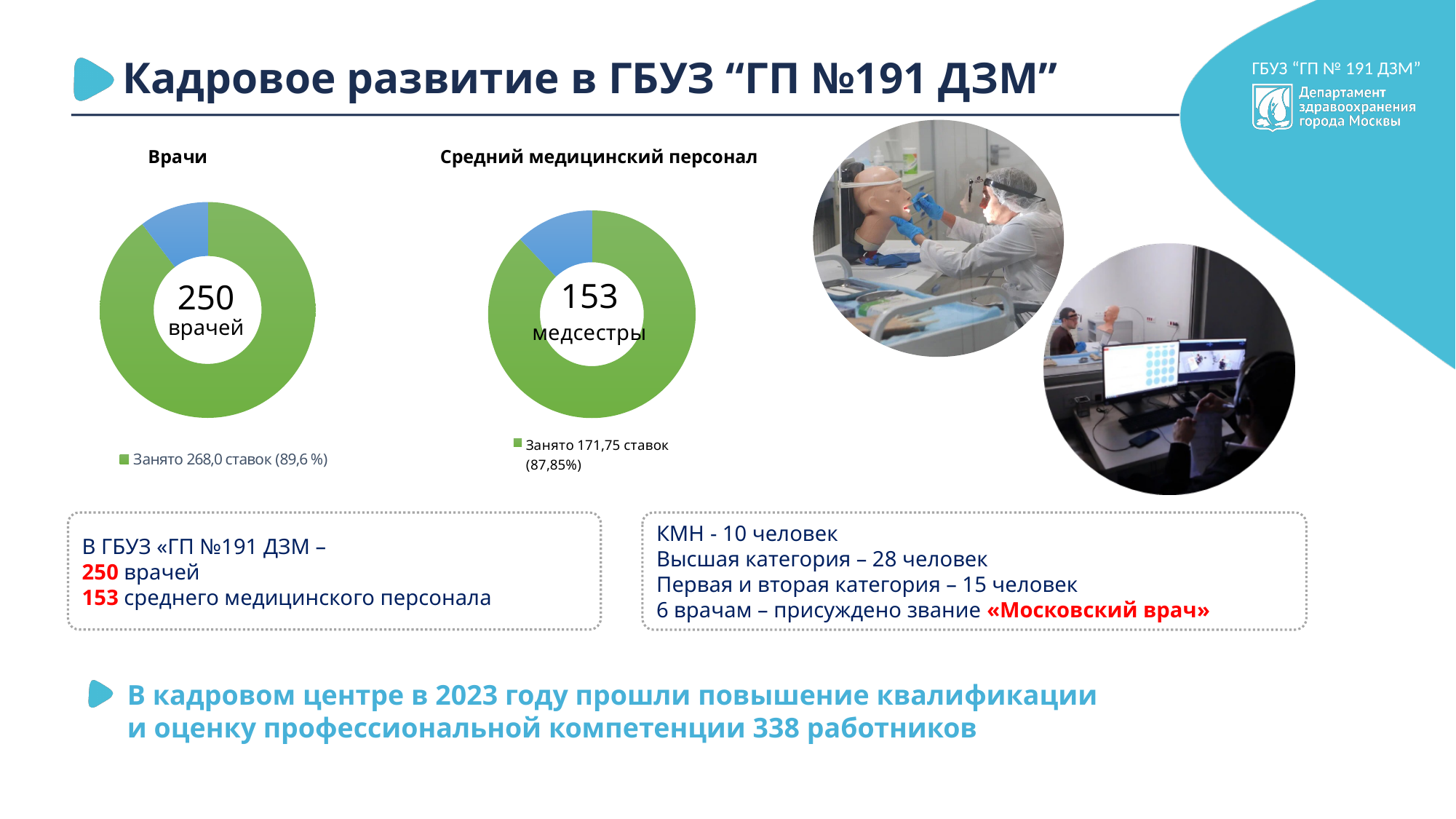
In the "Врачи" chart, is the occupied share greater or less than 50%? greater In the "Врачи" chart, what colour is the segment representing occupied positions (Занято)? Green In the "Врачи" chart, what share of positions is shown as occupied (Занято) in the legend? 89,6 % How many entries does the legend of the "Средний медицинский персонал" chart list? 1 In the "Врачи" chart, how many occupied positions (ставок) does the legend report? 268,0 In the "Средний медицинский персонал" chart, what share of positions is shown as occupied (Занято) in the legend? 87,85% Which chart shows the larger occupied share: "Врачи" or "Средний медицинский персонал"? Врачи What type of chart is used under the heading "Врачи"? Donut (pie) chart In the "Средний медицинский персонал" chart, what number is shown in the centre of the donut? 153 In the "Врачи" chart, what number is shown in the centre of the donut? 250 How many donut charts are shown on the slide? 2 In the "Средний медицинский персонал" chart, how many occupied positions (ставок) does the legend report? 171,75